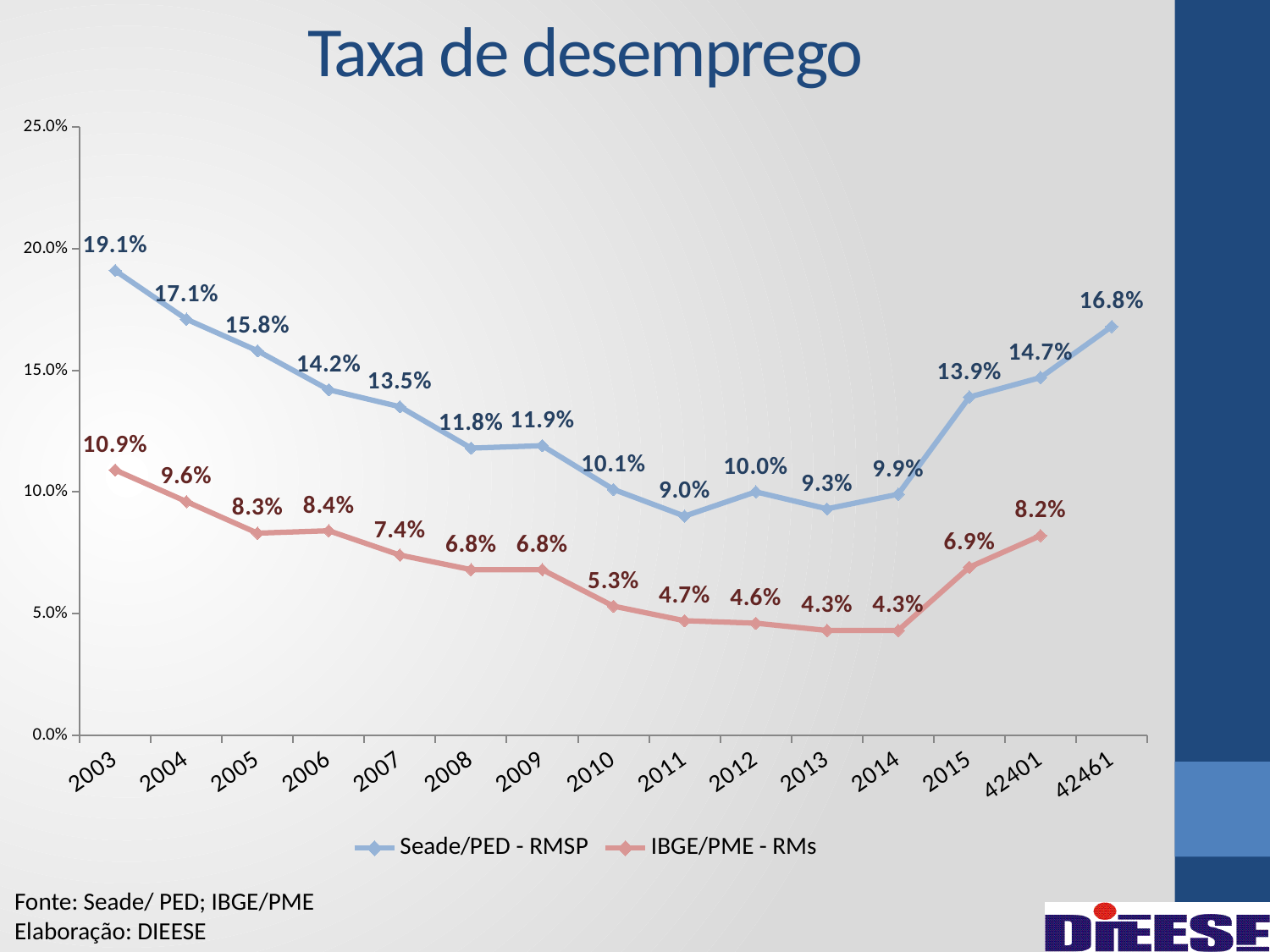
What kind of chart is shown on the slide? Line chart How many series does the legend list? 2 What is the value for Seade/PED - RMSP in 2003? 19.1% What is the value for Seade/PED - RMSP at the category labelled 42461? 16.8% What is the difference between the Seade/PED - RMSP and IBGE/PME - RMs values in 2015? 7.0% Does the IBGE/PME - RMs series rise or fall from 2003 to 2013? Fall In which year does the Seade/PED - RMSP series reach its lowest value? 2011 Which series has the larger value in 2008, Seade/PED - RMSP or IBGE/PME - RMs? Seade/PED - RMSP What is the highest value shown for the IBGE/PME - RMs series? 10.9% How many categories are shown on the x axis? 15 What is the value for IBGE/PME - RMs in 2010? 5.3% Is the value for Seade/PED - RMSP in 2004 greater or less than 15.0%? greater